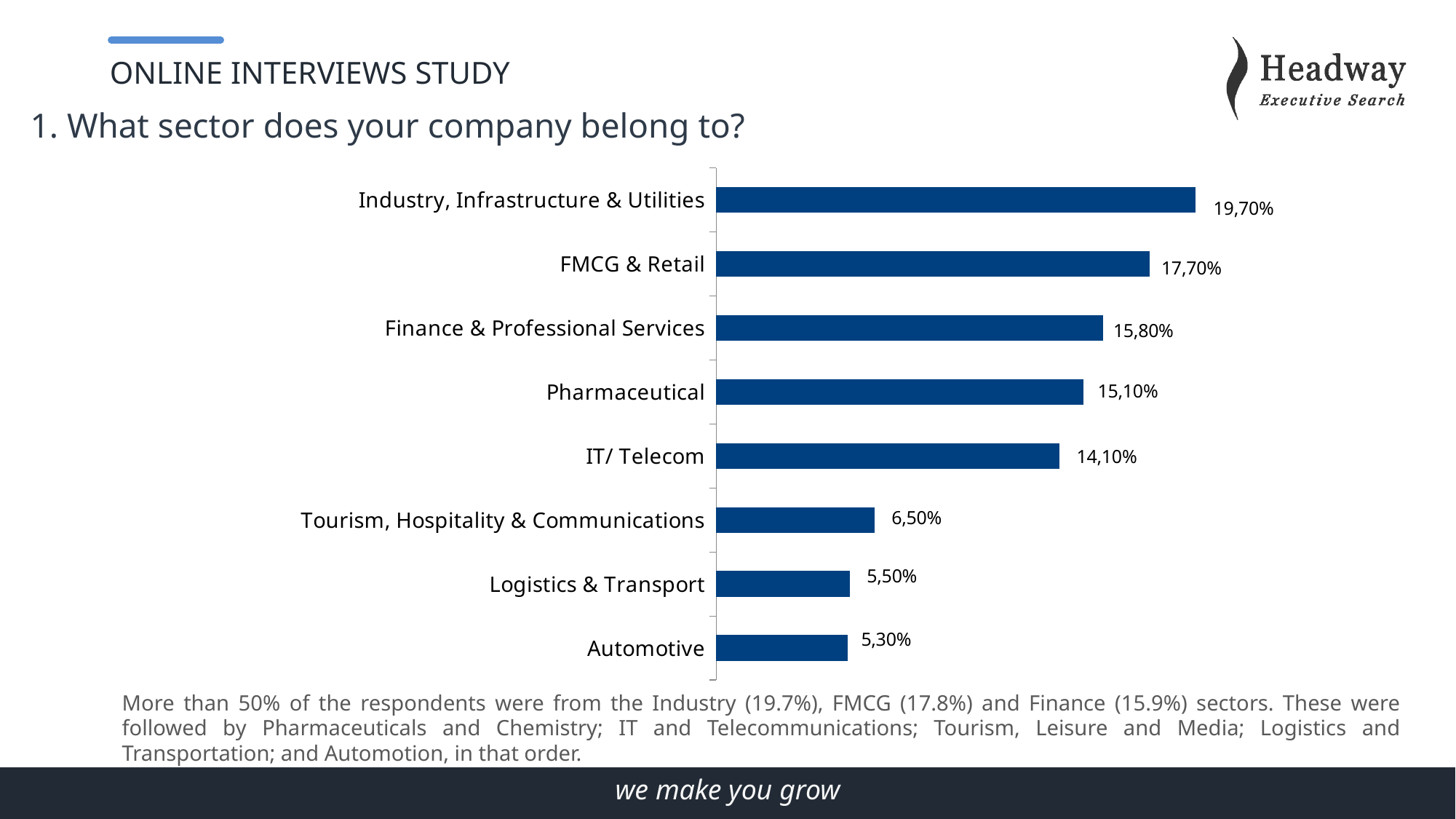
Which is larger, the value for IT/ Telecom or the value for Tourism, Hospitality & Communications? IT/ Telecom What question is the chart answering, according to the slide heading? What sector does your company belong to? Which sector has the lowest value? Automotive What is the difference between the values for Pharmaceutical and IT/ Telecom? 1,00% How many sectors are shown in the chart? 8 What kind of chart is shown on the slide? Bar chart Which is larger, the value for Finance & Professional Services or the value for Pharmaceutical? Finance & Professional Services What value is shown for Logistics & Transport? 5,50% Which sector has the highest value? Industry, Infrastructure & Utilities What value is shown for FMCG & Retail? 17,70% What is the difference between the values for Industry, Infrastructure & Utilities and FMCG & Retail? 2,00% What value is shown for Pharmaceutical? 15,10%